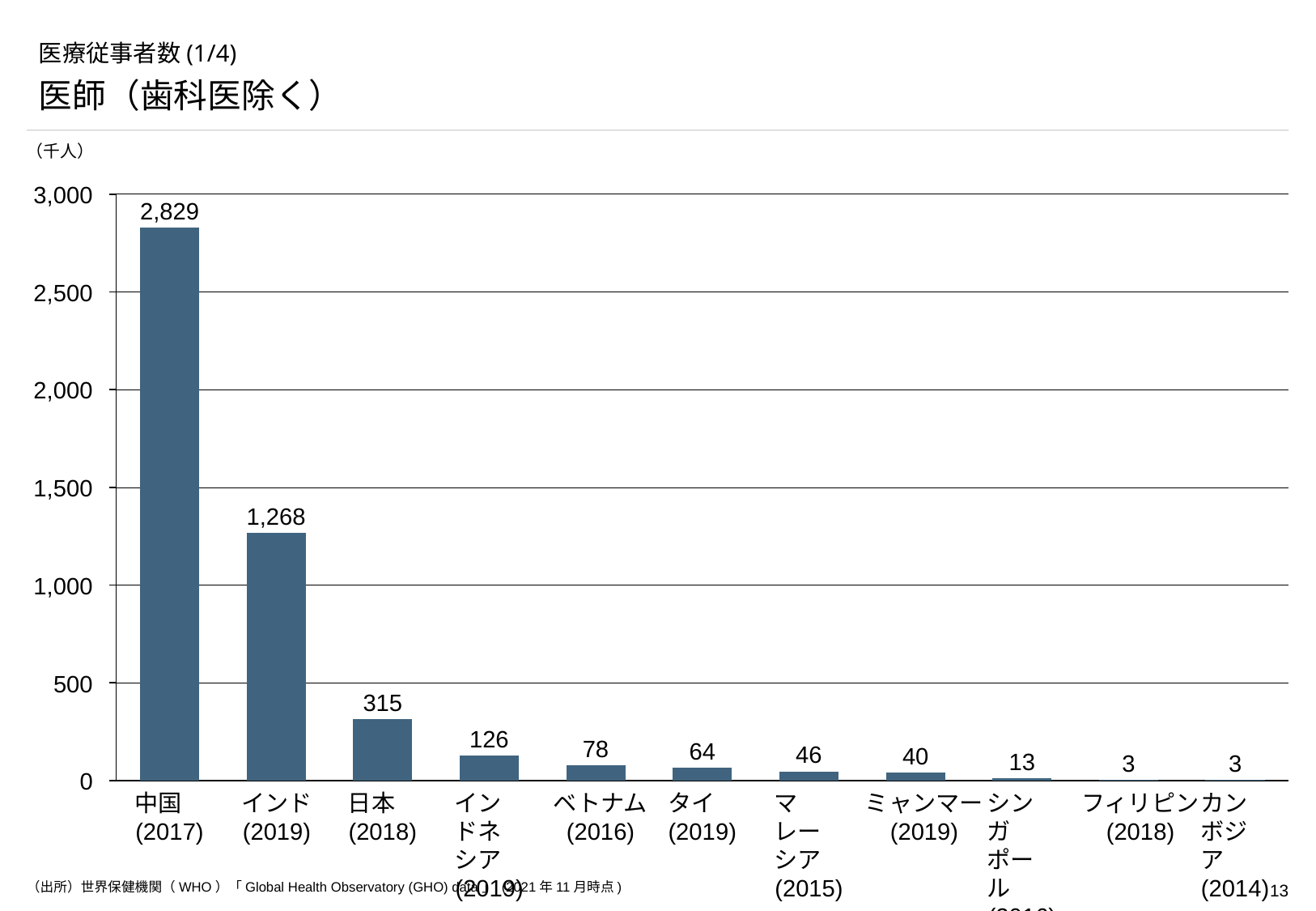
How many countries are shown in the chart? 11 What is the difference between the values for 日本 (2018) and インドネシア (2019)? 189 Which country has the highest value in the chart? 中国 (2017) What is the value for 中国 (2017)? 2,829 What is the difference between the values for 中国 (2017) and インド (2019)? 1,561 What is the value for インド (2019)? 1,268 What is the value for ベトナム (2016)? 78 What kind of chart is shown on the slide? Bar chart What unit is indicated above the vertical axis of the chart? 千人 Which is larger, the value for タイ (2019) or the value for マレーシア (2015)? タイ (2019) What is the value for ミャンマー (2019)? 40 What is the value for 日本 (2018)? 315